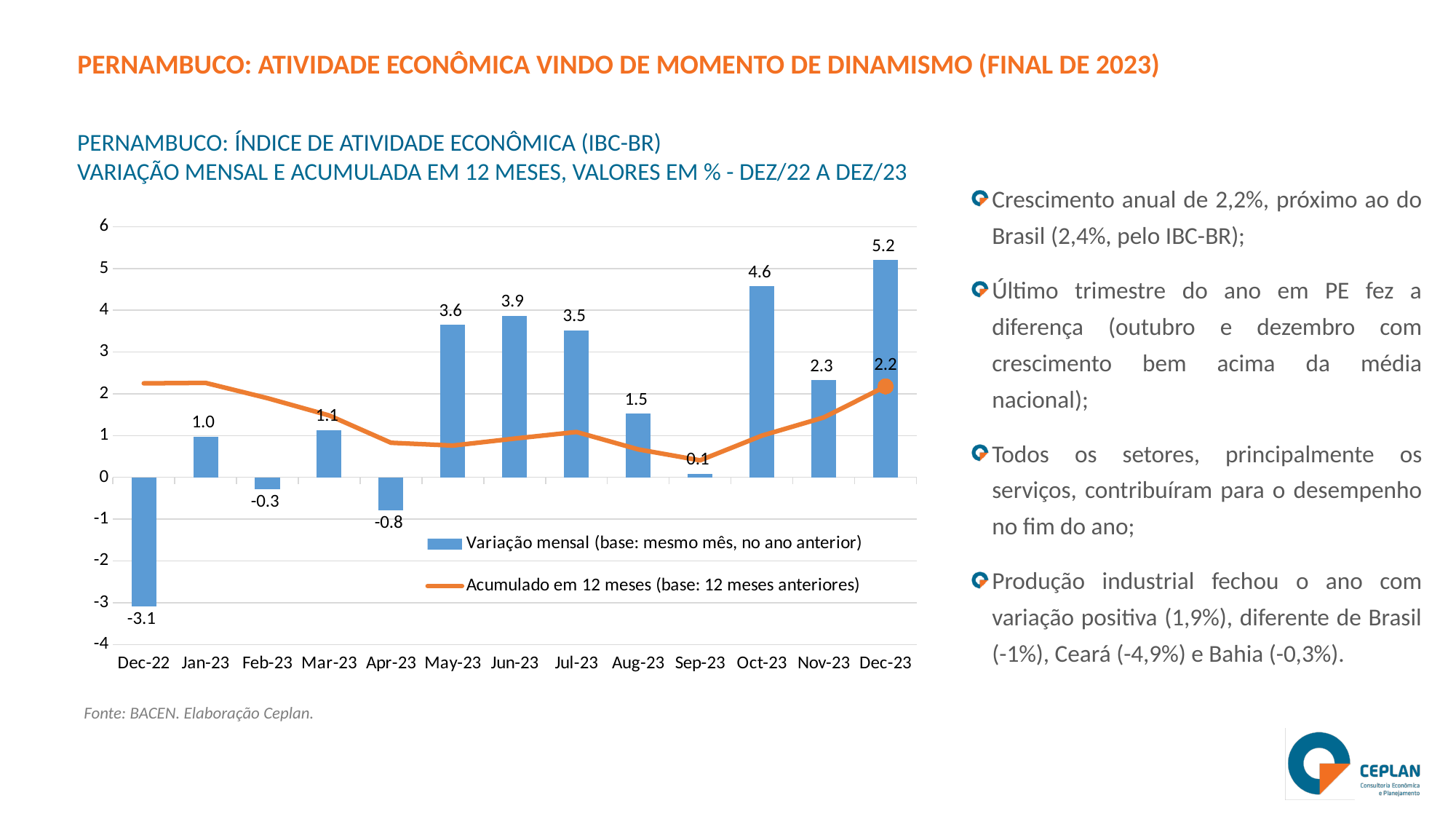
What is the value of Variação mensal for Dec-22? -3.1 How many series does the legend list? 2 Is the Acumulado em 12 meses value for Dec-22 greater or less than 1? greater Which is larger, the Variação mensal value for Jun-23 or for Jul-23? Jun-23 Which month has the lowest Variação mensal value? Dec-22 What is the difference between the Variação mensal values for Oct-23 and Nov-23? 2.3 Which month has the highest Variação mensal value? Dec-23 What is the source cited below the chart? Fonte: BACEN. Elaboração Ceplan. What kind of chart is used for the Variação mensal series? Bar chart What is the value of Acumulado em 12 meses for Dec-23? 2.2 What is the value of Variação mensal for Dec-23? 5.2 How many months are shown on the x axis? 13